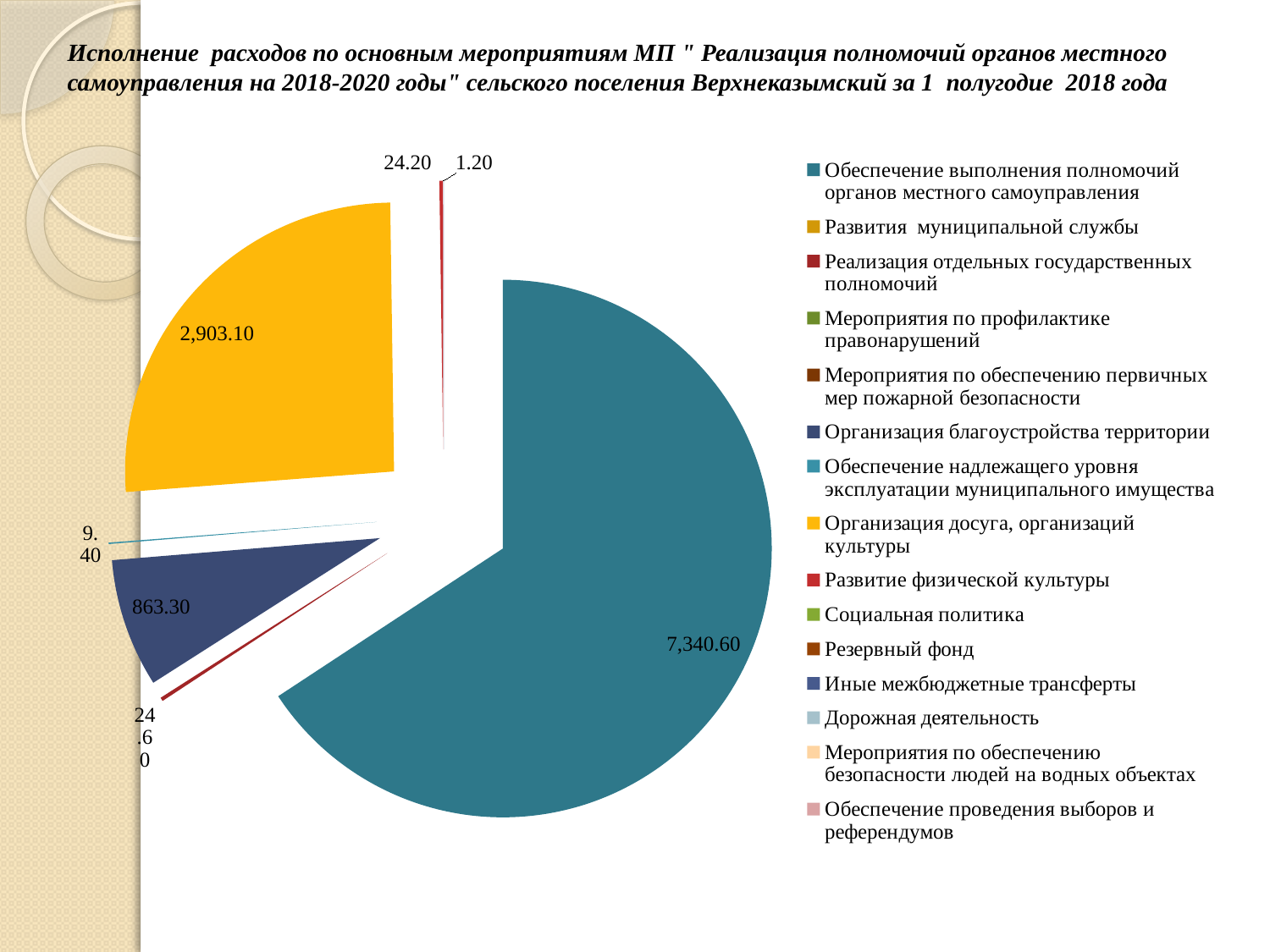
Which period does the chart title say the expenditure data covers? 1 полугодие 2018 года What is the value shown for 'Обеспечение выполнения полномочий органов местного самоуправления'? 7,340.60 Is the value of the largest slice greater or less than 5,000? greater What is the value of the largest slice of the pie chart? 7,340.60 What type of chart is shown on the slide? pie chart What is the difference between the slice labelled 2,903.10 and the slice labelled 863.30? 2,039.80 How many entries does the legend of the pie chart list? 15 Which is larger: the slice labelled 9.40 or the slice labelled 24.20? 24.20 What is the difference between the slice labelled 7,340.60 and the slice labelled 2,903.10? 4,437.50 What is the smallest value labelled on the pie chart? 1.20 What colour is the largest slice of the pie chart? teal Which is larger: the slice labelled 863.30 or the slice labelled 2,903.10? 2,903.10